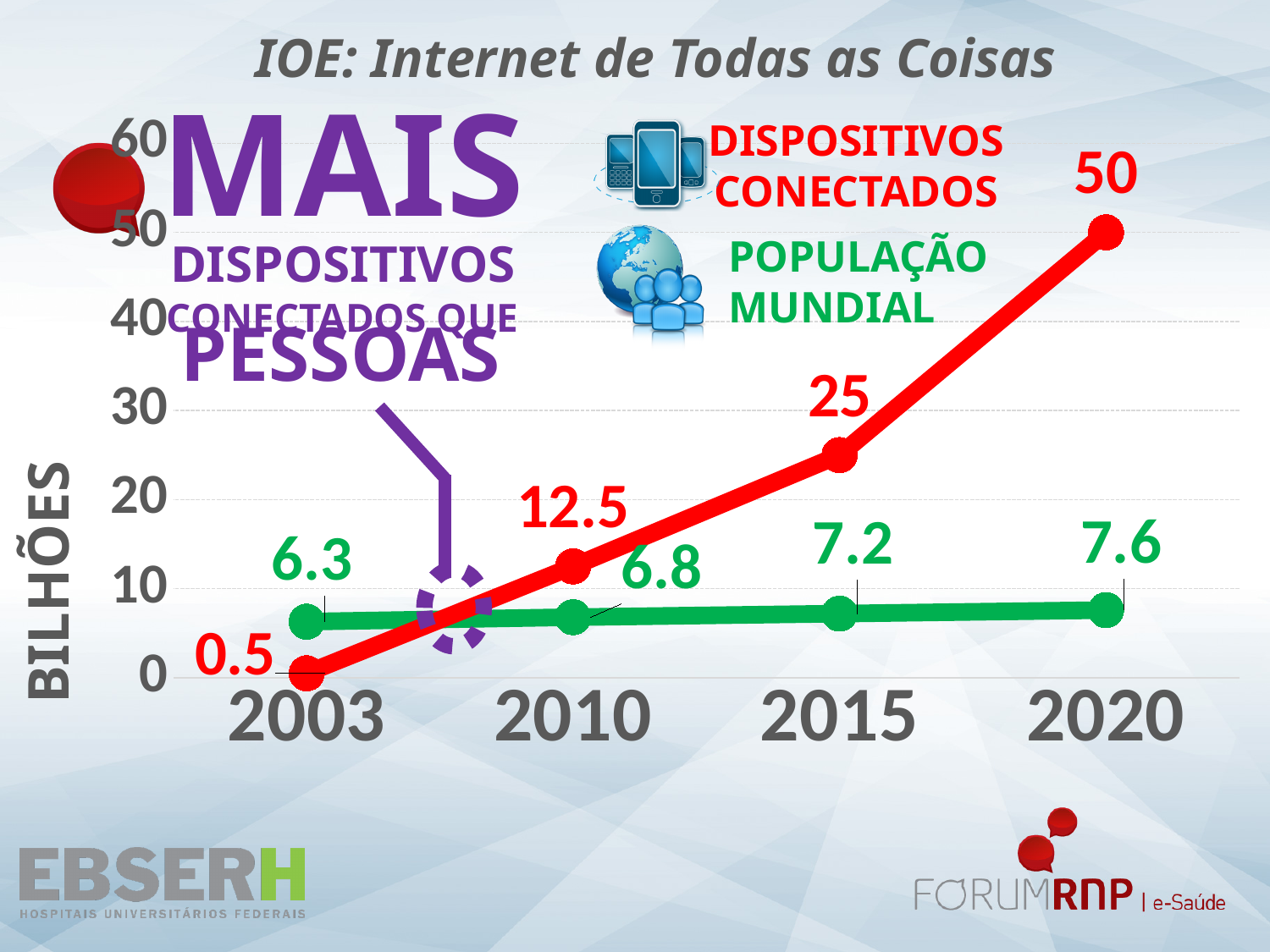
What is the value for Dispositivos Conectados in 2020? 50 Do the Dispositivos Conectados values rise or fall from 2003 to 2020? rise What kind of chart is shown? line chart How many years are shown on the x axis? 4 In which year is the População Mundial value highest? 2020 How many series does the legend list? 2 In which year is the Dispositivos Conectados value lowest? 2003 What is the difference between Dispositivos Conectados and População Mundial in 2020? 42.4 What is the value for População Mundial in 2003? 6.3 What is the value for População Mundial in 2015? 7.2 Which is larger in 2003, Dispositivos Conectados or População Mundial? População Mundial What is the value for Dispositivos Conectados in 2010? 12.5